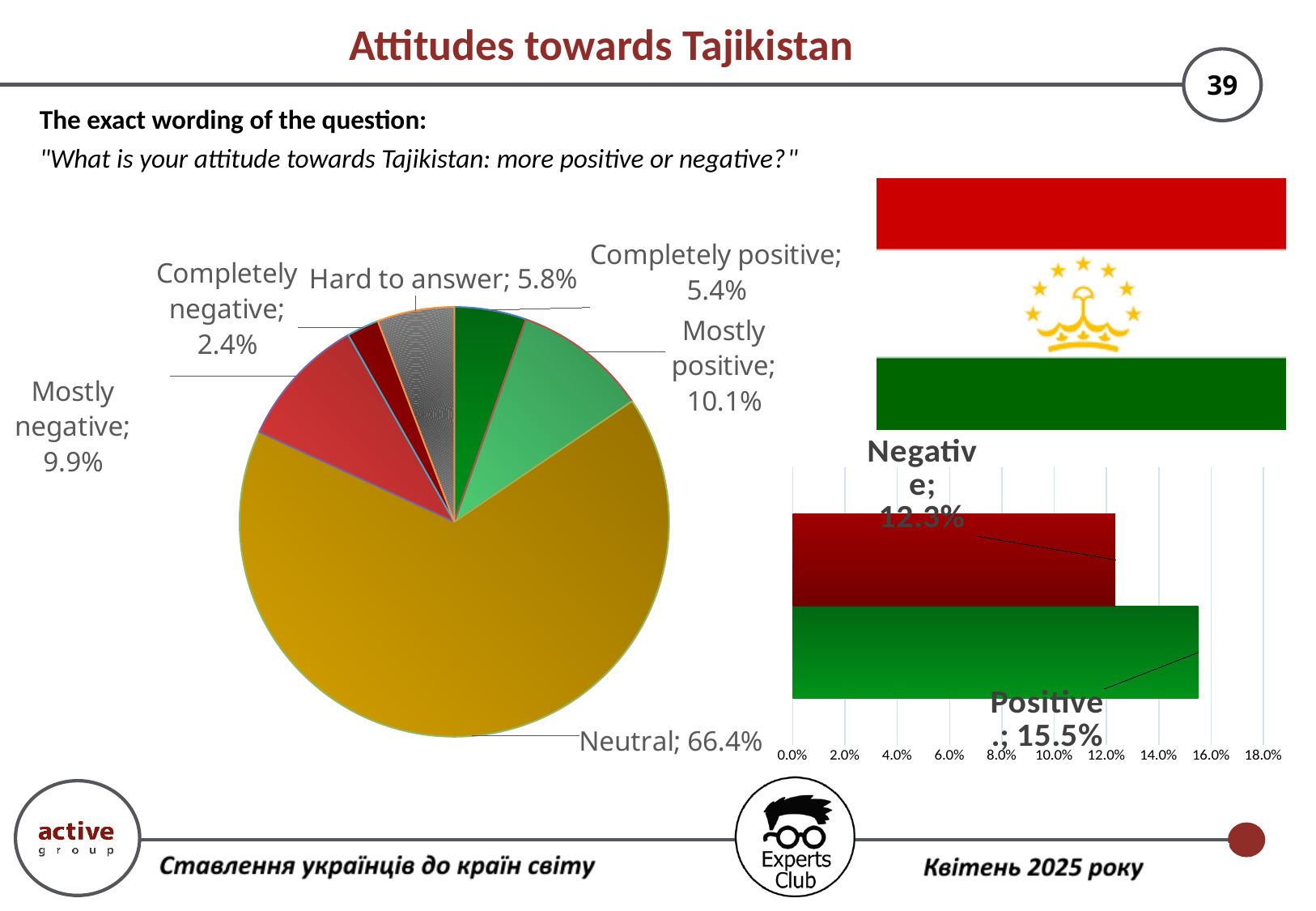
In the pie chart, what is the value for Completely negative? 2.4% What type of chart is shown on the right side of the slide? Bar chart In the pie chart, what is the value for Mostly positive? 10.1% In the bar chart on the right, what is the difference between Positive and Negative? 3.2% How many categories does the pie chart show? 6 In the pie chart, what is the difference between Mostly positive and Mostly negative? 0.2% In the pie chart, which category has the largest slice? Neutral In the pie chart, which is larger: Completely positive or Hard to answer? Hard to answer In the bar chart on the right, what is the value for Positive? 15.5% In the pie chart, what share of respondents answered Neutral? 66.4% In the pie chart, which category has the smallest slice? Completely negative In the pie chart, what is the value for Hard to answer? 5.8%